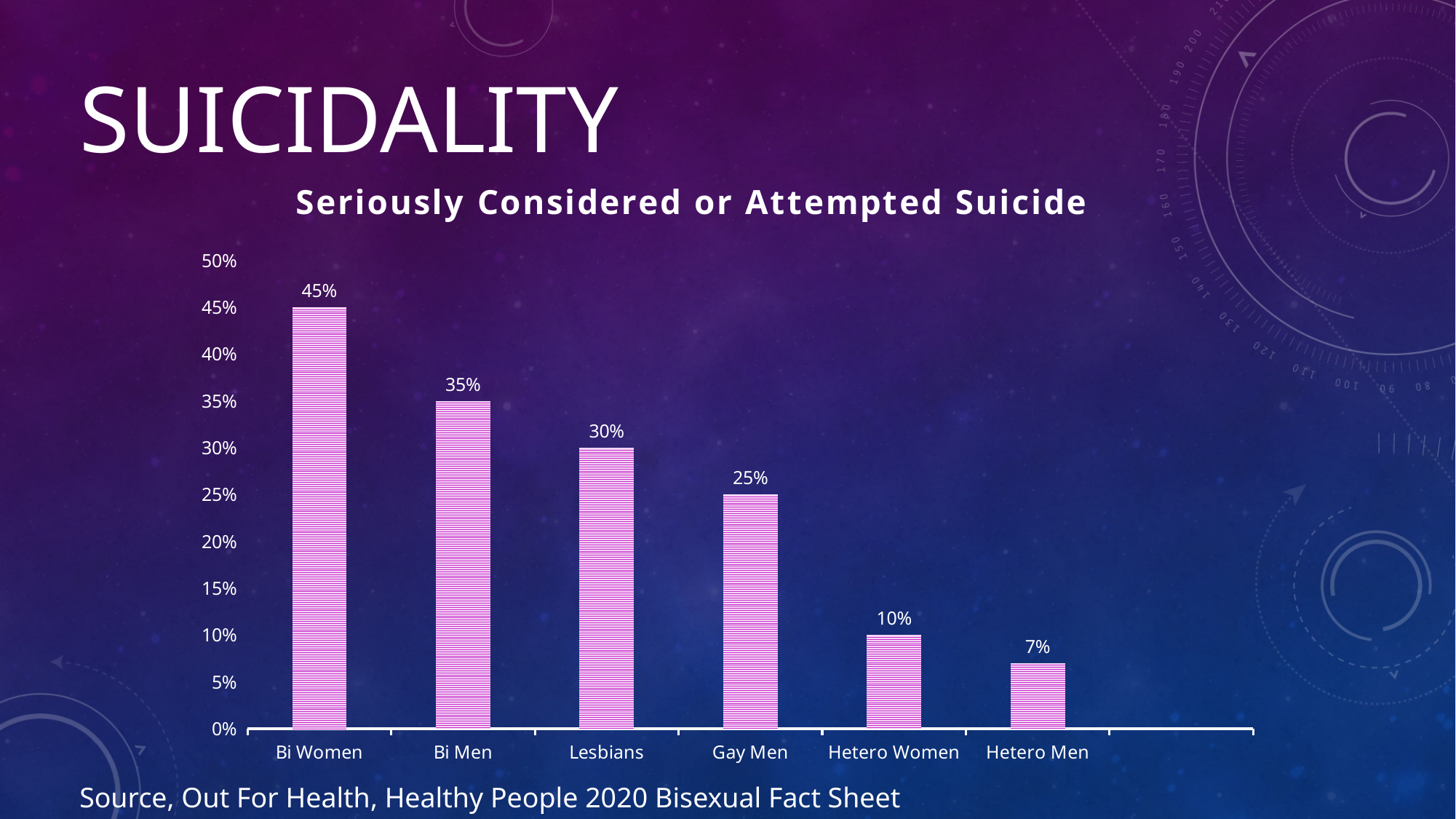
How many categories are shown on the x axis? 6 Is the value for Gay Men greater or less than 20%? greater Do the values rise or fall from left to right along the x axis? fall What is the difference between the values for Bi Men and Gay Men? 10% Which category has the highest value? Bi Women What kind of chart is this? bar chart What is the title of the chart? Seriously Considered or Attempted Suicide Which is larger, the value for Lesbians or the value for Hetero Women? Lesbians What is the value for Bi Women? 45% What is the value for Hetero Men? 7% Which category has the lowest value? Hetero Men What is the value for Lesbians? 30%